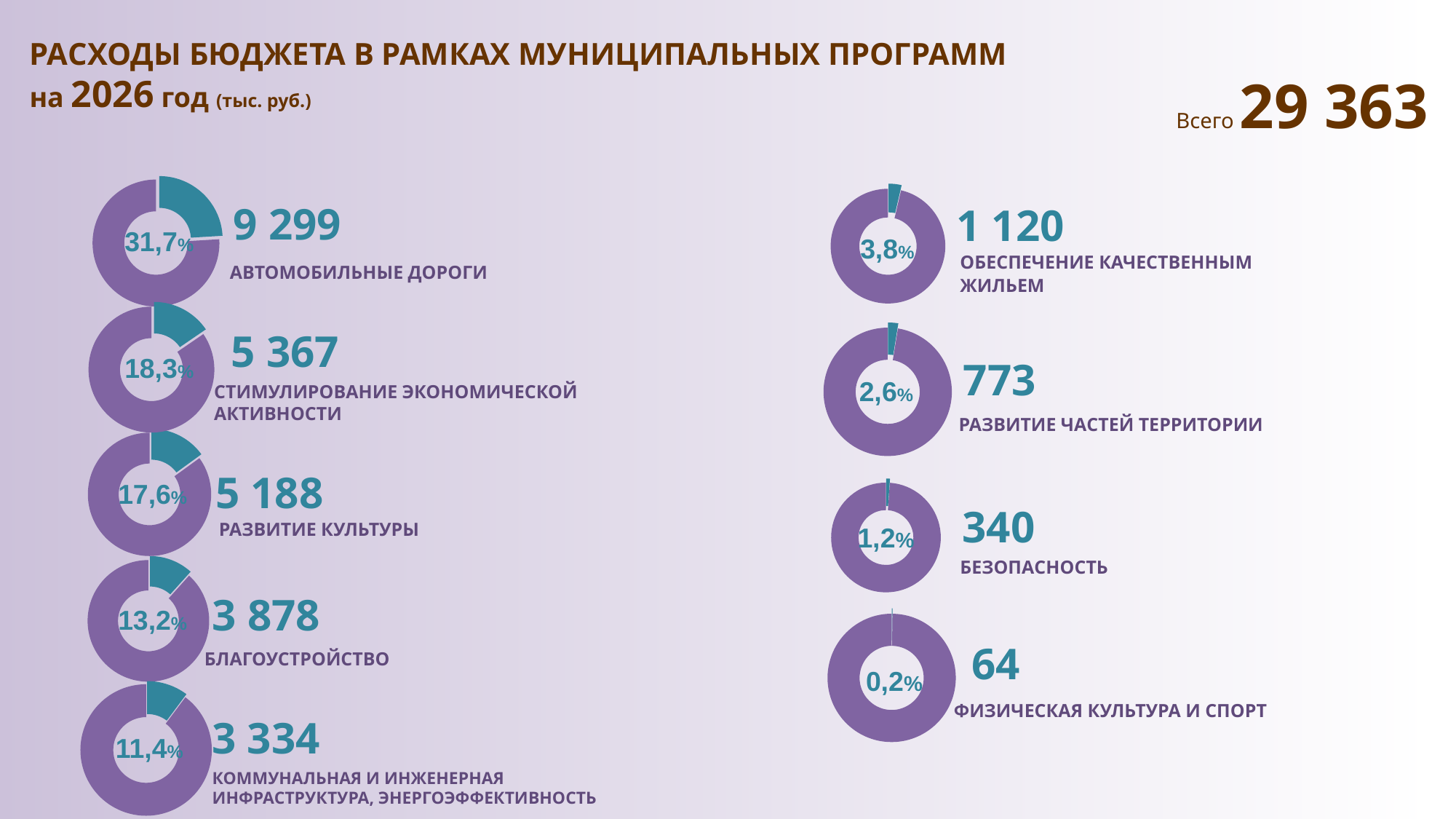
What percentage is shown inside the "РАЗВИТИЕ КУЛЬТУРЫ" donut chart? 17,6% What value is shown for the "БЕЗОПАСНОСТЬ" donut chart? 340 What percentage is shown inside the "ОБЕСПЕЧЕНИЕ КАЧЕСТВЕННЫМ ЖИЛЬЕМ" donut chart? 3,8% What value is shown for the "АВТОМОБИЛЬНЫЕ ДОРОГИ" donut chart? 9 299 What total ("Всего") is shown on the slide? 29 363 What percentage is shown inside the "РАЗВИТИЕ ЧАСТЕЙ ТЕРРИТОРИИ" donut chart? 2,6% Which program has the lowest value among the donut charts on the slide? ФИЗИЧЕСКАЯ КУЛЬТУРА И СПОРТ Which program has the highest value among the donut charts on the slide? АВТОМОБИЛЬНЫЕ ДОРОГИ What kind of chart is used to show each program's share on the slide? Donut (pie) chart How many donut charts are on the slide? 9 What is the difference between the values for "СТИМУЛИРОВАНИЕ ЭКОНОМИЧЕСКОЙ АКТИВНОСТИ" and "РАЗВИТИЕ КУЛЬТУРЫ"? 179 Which is larger: the value for "БЛАГОУСТРОЙСТВО" or the value for "КОММУНАЛЬНАЯ И ИНЖЕНЕРНАЯ ИНФРАСТРУКТУРА, ЭНЕРГОЭФФЕКТИВНОСТЬ"? БЛАГОУСТРОЙСТВО